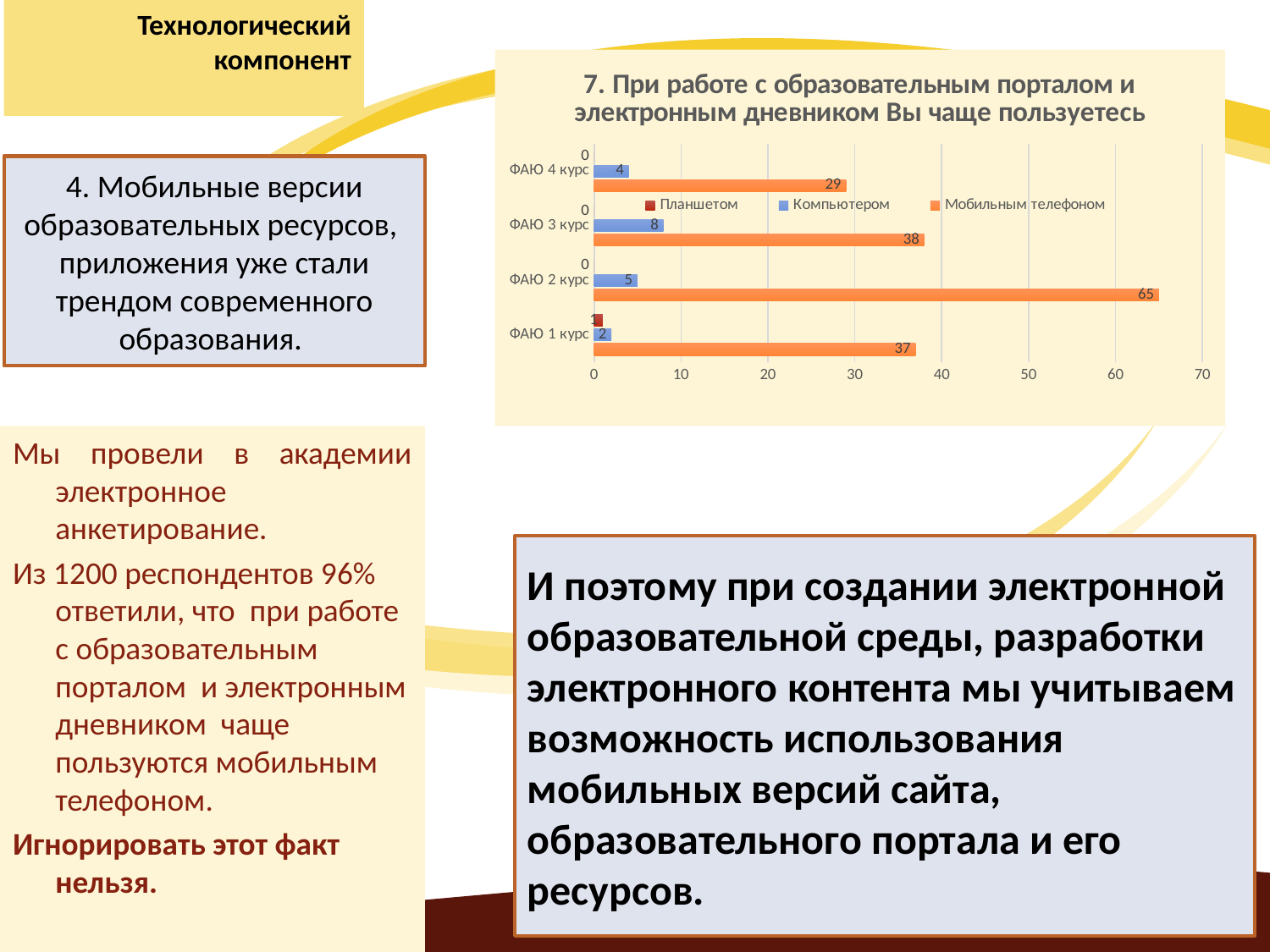
Is the Мобильным телефоном value for ФАЮ 2 курс greater or less than 60? greater How many series does the chart legend list? 3 What kind of chart is shown on the slide? bar chart Which series is shown in orange in the chart legend? Мобильным телефоном Which course group has the lowest value for Компьютером? ФАЮ 1 курс Which course group has the highest value for Мобильным телефоном? ФАЮ 2 курс What is the difference between the Мобильным телефоном values for ФАЮ 3 курс and ФАЮ 4 курс? 9 What is the value for Планшетом for ФАЮ 1 курс? 1 What is the value for Компьютером for ФАЮ 3 курс? 8 How many course groups (categories) are shown on the chart? 4 Which is larger: the Мобильным телефоном value for ФАЮ 1 курс or for ФАЮ 4 курс? ФАЮ 1 курс What is the value for Мобильным телефоном for ФАЮ 2 курс? 65